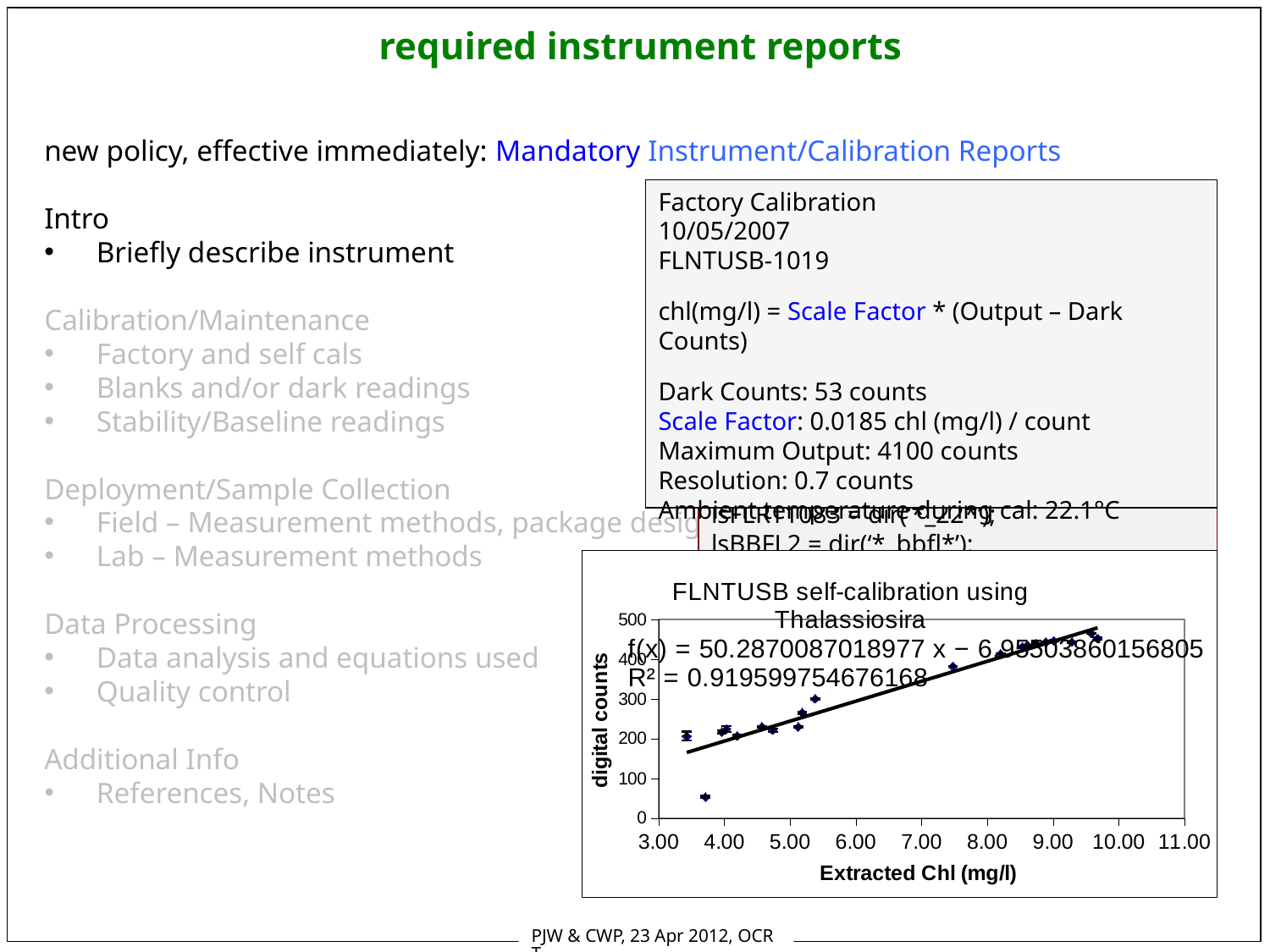
Is the digital counts value of the point plotted at about 7.5 mg/l Extracted Chl greater or less than 300? greater What R² value is printed on the chart for the fitted line? 0.919599754676168 Is the digital counts value of the highest plotted point greater or less than 400? greater What is the maximum value shown on the y axis of the chart? 500 Do the digital counts generally rise or fall as Extracted Chl increases along the x axis? rise Which has higher digital counts: the point plotted near 3.7 mg/l or the point plotted near 9.6 mg/l Extracted Chl? the point near 9.6 mg/l What is the label of the x axis of the chart? Extracted Chl (mg/l) What is the slope of the fitted line equation printed on the chart? 50.2870087018977 Is the digital counts value of the point plotted at about 3.5 mg/l Extracted Chl greater or less than 100? greater What kind of chart is shown on the slide? scatter chart What is the title of the chart on the slide? FLNTUSB self-calibration using Thalassiosira